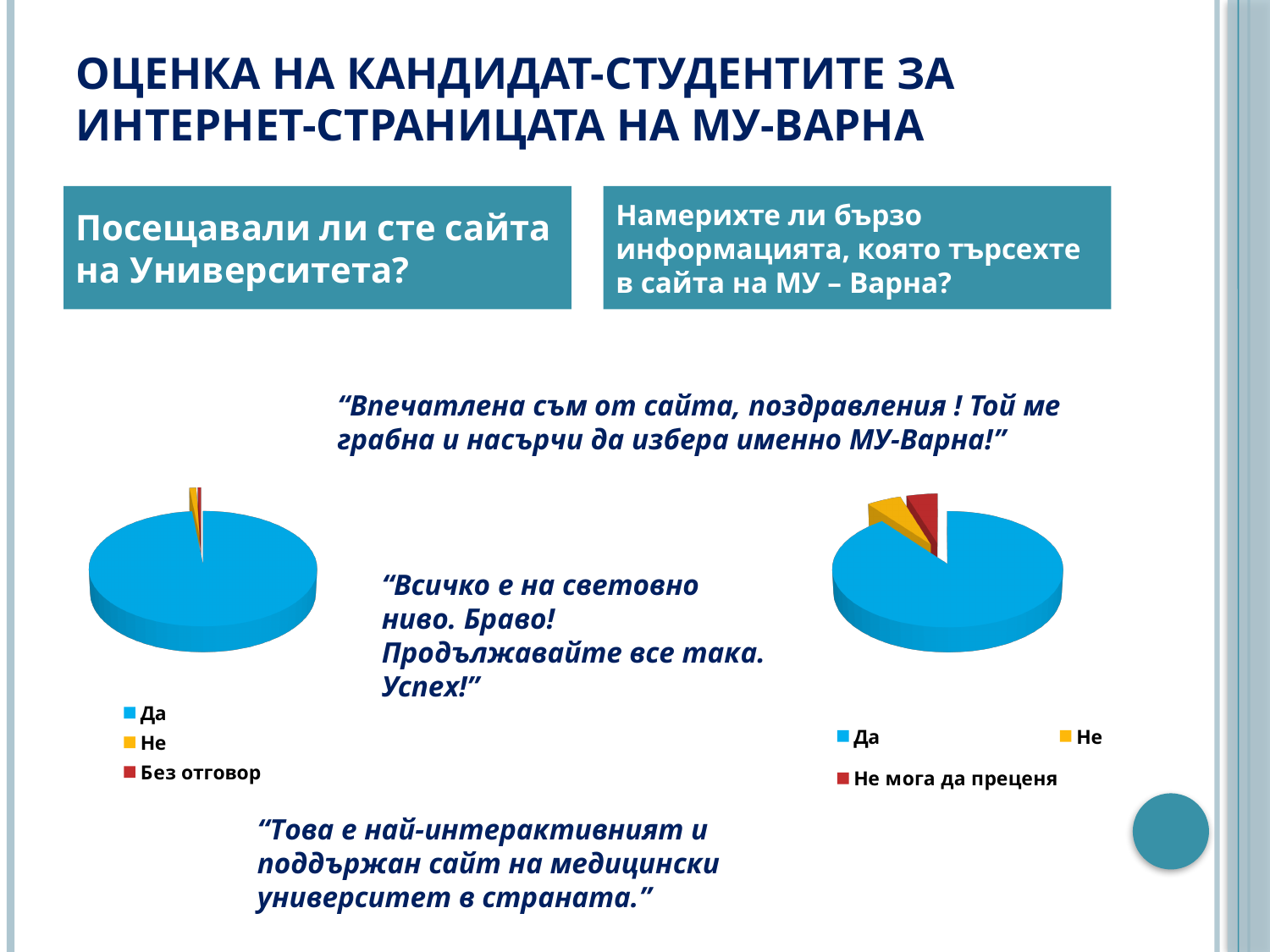
In the right chart ("Намерихте ли бързо информацията..."), which category has the largest slice? Да In the right chart, which slice is larger: Да or Не мога да преценя? Да What are the three legend entries of the left chart? Да, Не, Без отговор In the right chart, which slice is larger: Не or Да? Да What are the three legend entries of the right chart? Да, Не, Не мога да преценя What kind of chart is the right chart, under "Намерихте ли бързо информацията, която търсехте в сайта на МУ – Варна?"? pie chart In the left chart ("Посещавали ли сте сайта на Университета?"), which category has the largest slice? Да How many categories does the legend of the right chart list? 3 How many categories does the legend of the left chart list? 3 How many pie charts are shown on the slide? 2 In the left chart, which slice is larger: Да or Не? Да What kind of chart is the left chart, under "Посещавали ли сте сайта на Университета?"? pie chart